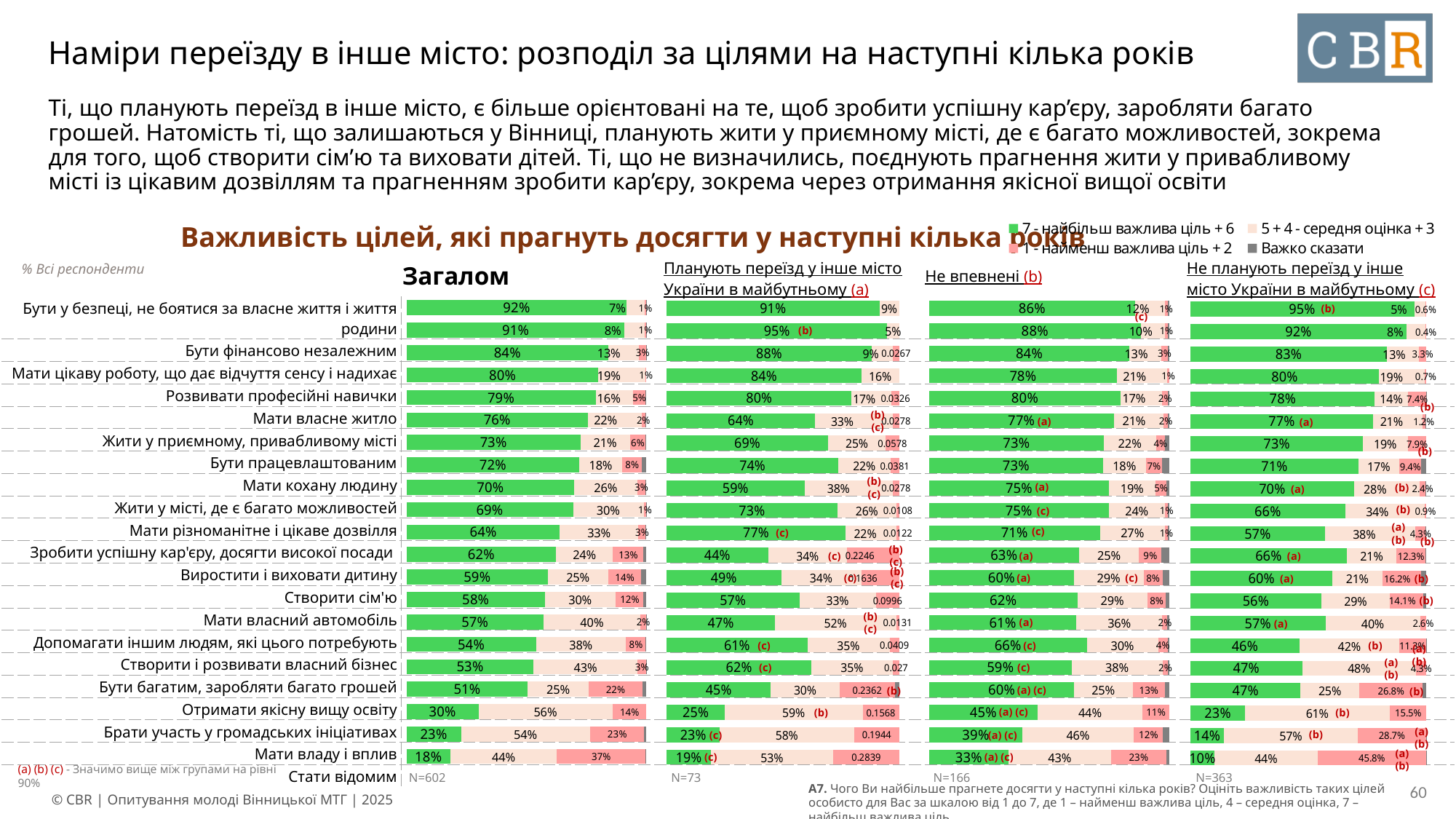
What is the sample size (N) shown under the "Загалом" chart? N=602 In the "Загалом" chart, what is the value of the 5 + 4 (середня оцінка + 3) segment for "Отримати якісну вищу освіту"? 56% In the "Загалом" chart, what percentage is shown for the green (7 - найбільш важлива ціль + 6) segment of "Бути фінансово незалежним"? 84% For "Зробити успішну кар'єру, досягти високої посади", is the green (7 + 6) share larger in the "Планують переїзд (a)" chart or in the "Не планують переїзд (c)" chart? Не планують переїзд (c) In the "Загалом" chart, what is the value of the 1 - найменш важлива ціль + 2 segment for "Бути багатим, заробляти багато грошей"? 22% What type of chart is used to show the importance of goals on this slide? Stacked bar chart In the "Загалом" chart, which goal has the lowest green (7 + 6) share? Мати владу і вплив In the "Загалом" chart, what is the difference in percentage points between the green (7 + 6) values for "Мати власне житло" and "Мати власний автомобіль"? 19 percentage points In the "Планують переїзд у інше місто України в майбутньому (a)" chart, what is the green (7 + 6) value for "Мати власний автомобіль"? 47% How many series does the legend list for these charts? 4 In the "Не впевнені (b)" chart, what is the green (7 + 6) value for "Бути багатим, заробляти багато грошей"? 60% In the "Не планують переїзд у інше місто України в майбутньому (c)" chart, what is the green (7 + 6) value for "Брати участь у громадських ініціативах"? 14%